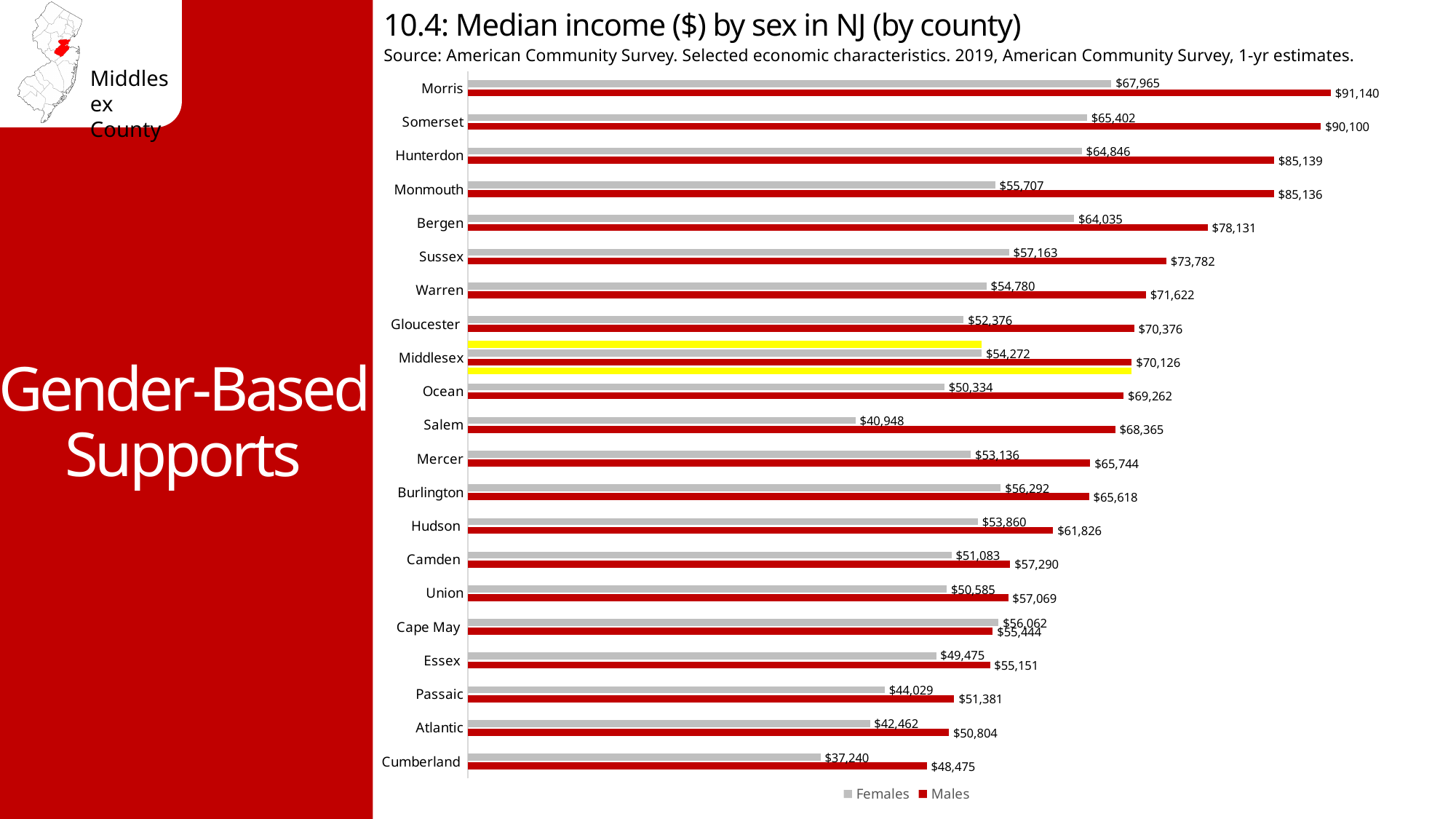
What is the median income for females in Salem County? $40,948 Which county has a higher median income for females, Bergen or Hudson? Bergen Which county has the lowest median income for females? Cumberland Which county has the highest median income for males? Morris What is the difference between male and female median income in Monmouth County? $29,429 How many series does the legend list? 2 In Cape May County, is the median income higher for females or for males? Females What is the median income for females in Morris County? $67,965 How many counties are shown in the chart? 21 What is the median income for males in Middlesex County? $70,126 What type of chart is used on this slide? Bar chart What is the difference between male and female median income in Middlesex County? $15,854